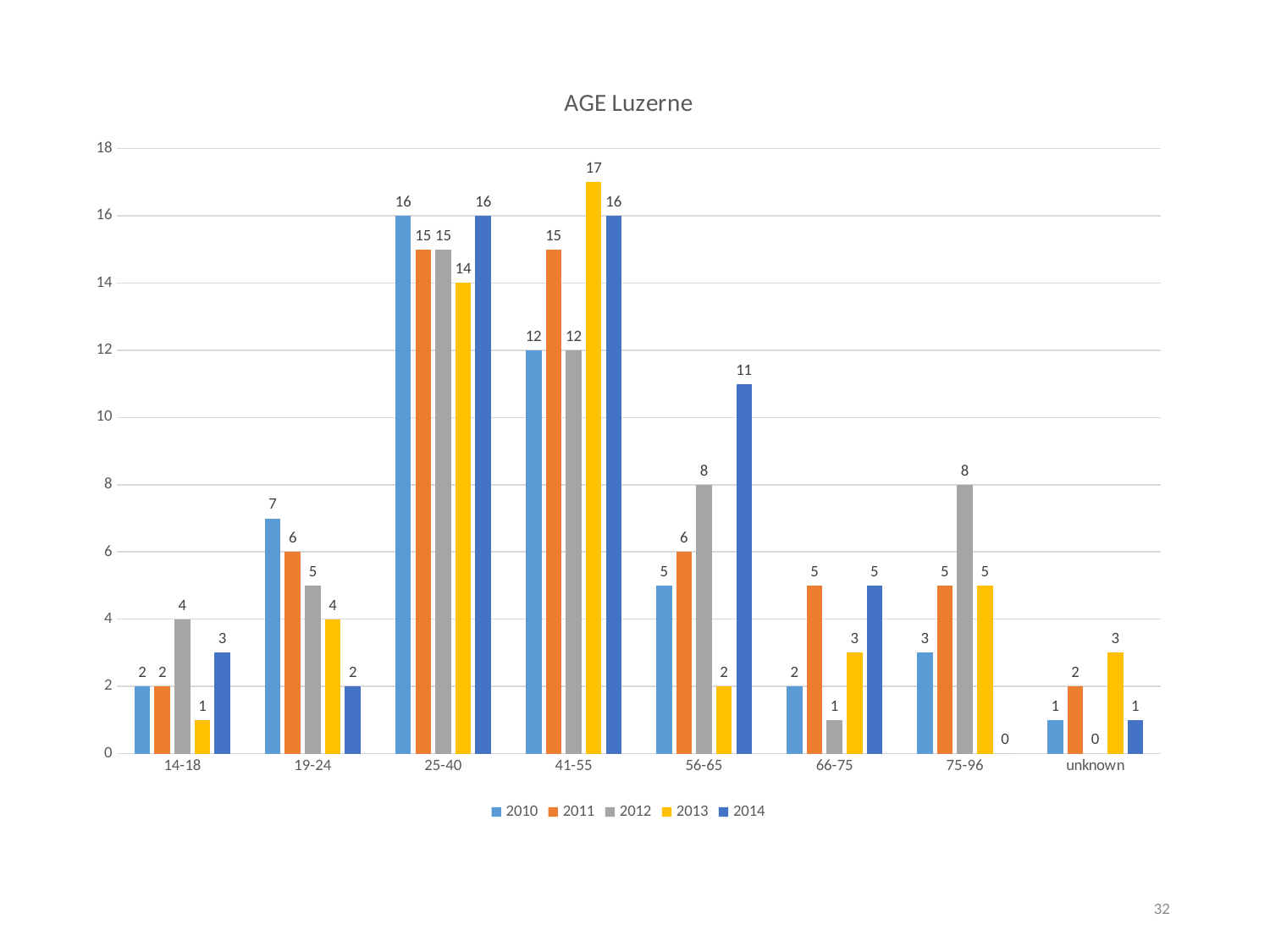
What kind of chart is shown on the slide? bar chart Which age group has the lowest value for the 2014 series? 75-96 How many age categories are shown on the x axis? 8 What is the difference between the 2014 and 2013 values in the 56-65 age group? 9 What is the difference between the 2012 and 2013 values in the 14-18 age group? 3 What is the value for 2012 in the 75-96 age group? 8 What is the value for 2013 in the 41-55 age group? 17 Which is larger in the 19-24 age group, the 2010 value or the 2014 value? 2010 What is the title of the chart? AGE Luzerne How many series does the legend list? 5 What is the value for 2014 in the 56-65 age group? 11 Which age group has the highest value for the 2010 series? 25-40